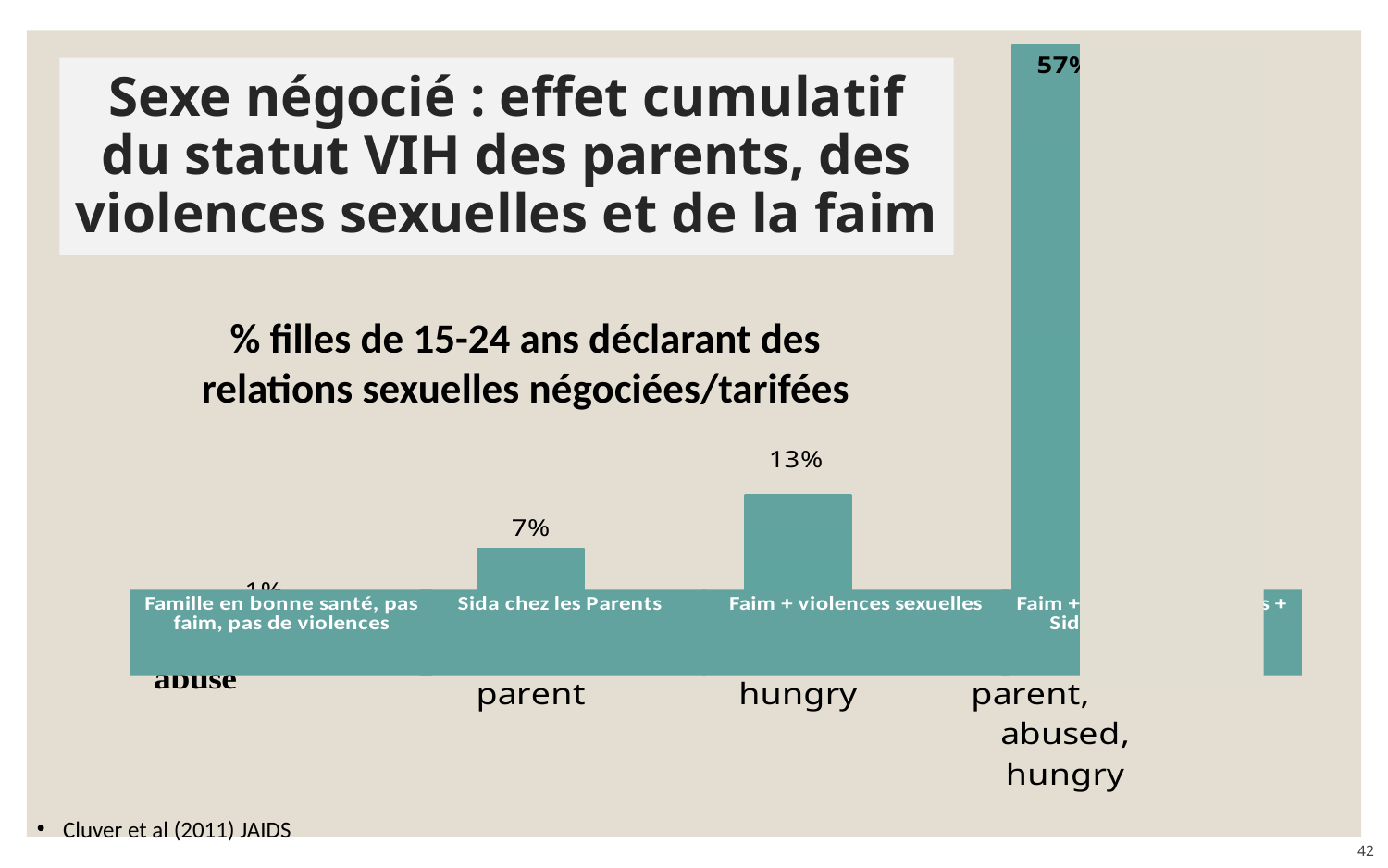
What value is shown on the tallest (rightmost) bar? 57% What is the difference between the values for "Faim + violences sexuelles" and "Sida chez les Parents"? 6 percentage points What colour are the bars in the chart? Teal Which bar is the highest in the chart? The rightmost bar What is the value for "Sida chez les Parents"? 7% What is the title of the chart? % filles de 15-24 ans déclarant des relations sexuelles négociées/tarifées Do the values rise or fall from left to right across the categories? Rise Which is larger: the value for "Sida chez les Parents" or for "Faim + violences sexuelles"? Faim + violences sexuelles How many bars are shown in the chart? 4 What kind of chart is shown on the slide? Bar chart What is the value for "Faim + violences sexuelles"? 13% Which category has the lowest value? Famille en bonne santé, pas faim, pas de violences